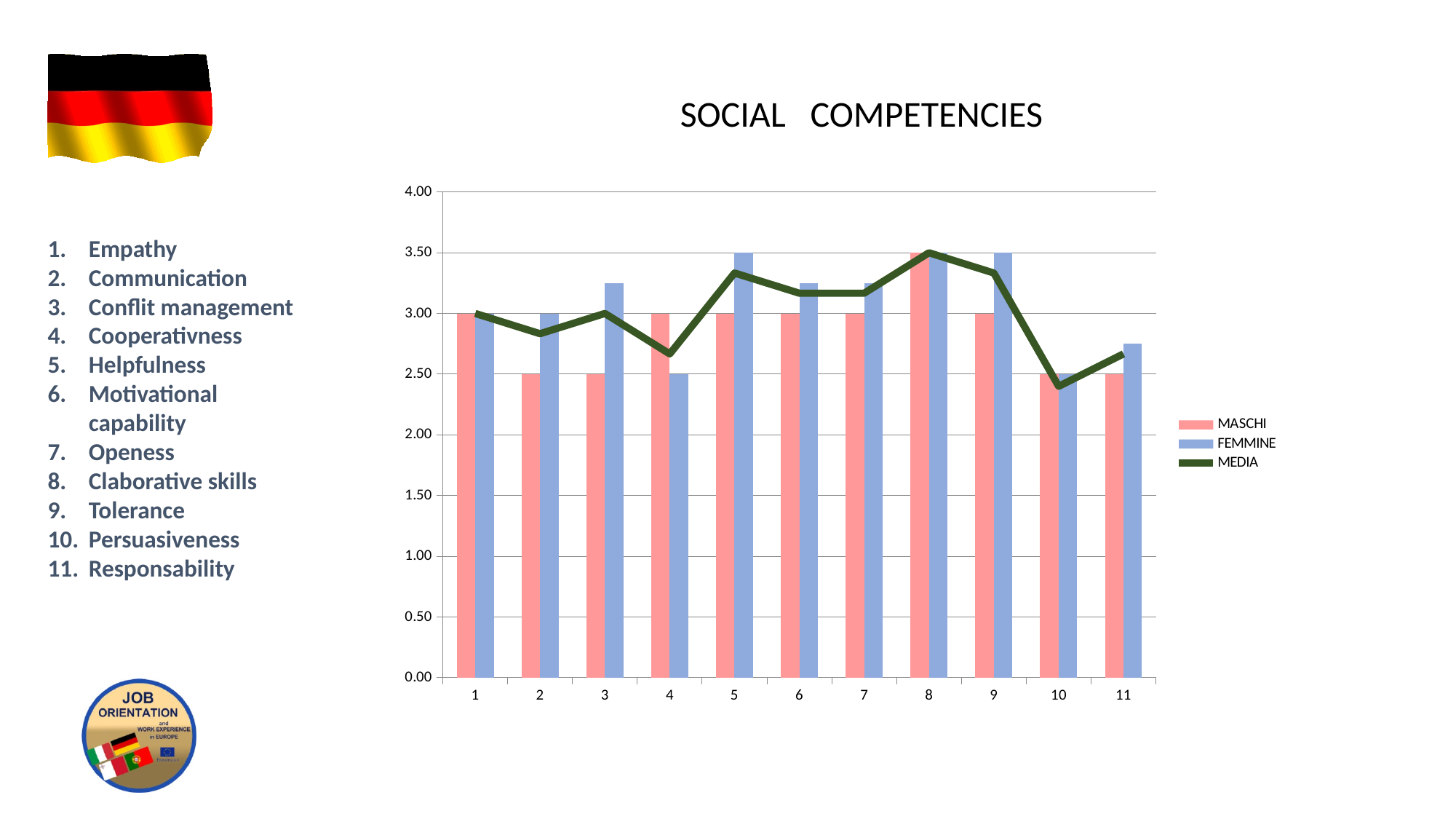
What is the FEMMINE value for category 5? 3.50 For category 3, which is larger, MASCHI or FEMMINE? FEMMINE What is the MASCHI value for category 8? 3.50 What is the FEMMINE value for category 10? 2.50 What is the title of the chart? SOCIAL COMPETENCIES Is the FEMMINE value for category 3 greater or less than 3.00? greater What is the difference between the MASCHI value for category 8 and the MASCHI value for category 2? 1.00 How many categories are shown on the x axis? 11 How many series does the legend list? 3 For category 4, which is larger, MASCHI or FEMMINE? MASCHI What is the MASCHI value for category 2? 2.50 Which category has the highest MASCHI value? 8